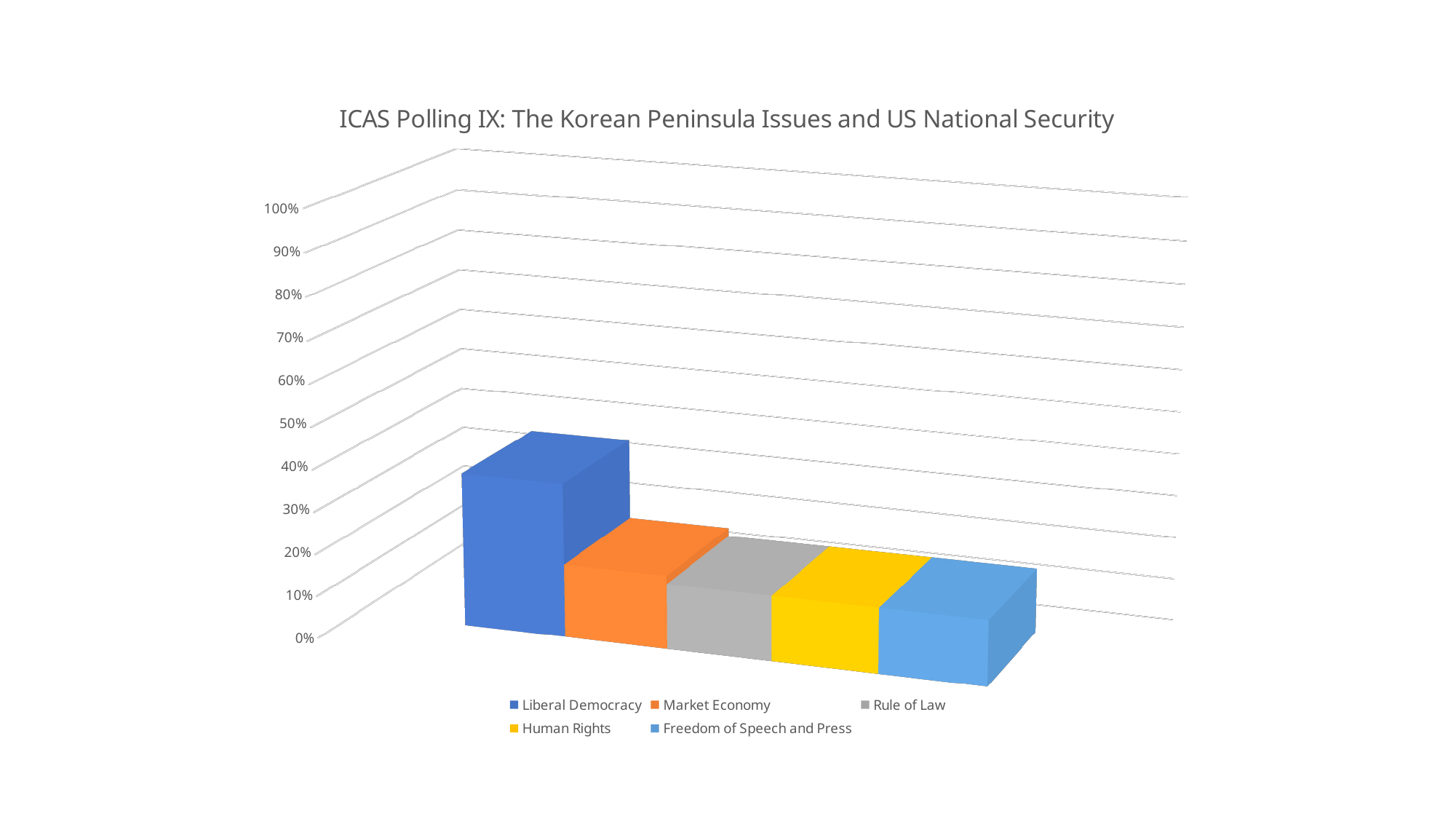
What is the title of the chart? ICAS Polling IX: The Korean Peninsula Issues and US National Security Which is larger, the value for Liberal Democracy or the value for Market Economy? Liberal Democracy Which is larger, the value for Liberal Democracy or the value for Human Rights? Liberal Democracy Is the value for Rule of Law greater or less than 30%? less Which series has the highest value? Liberal Democracy How many series does the legend list? 5 Is the value for Market Economy greater or less than 30%? less Is the value for Liberal Democracy greater or less than 20%? greater What kind of chart is shown on the slide? bar chart How many bars are plotted in the chart? 5 Which series is shown in orange in the legend? Market Economy